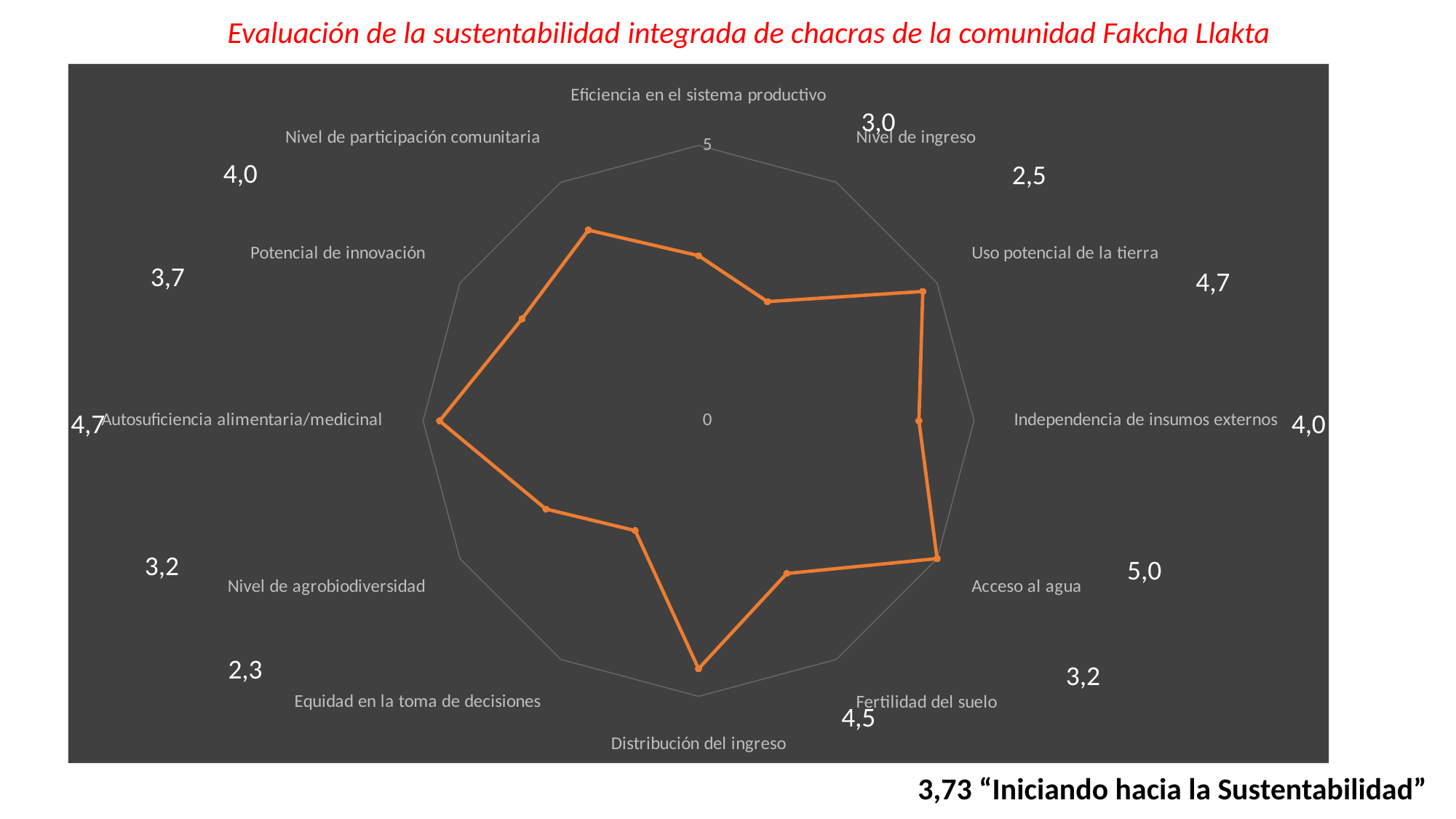
What is the value for Equidad en la toma de decisiones? 2,3 What is the maximum value shown on the radar chart's scale? 5 What is the value for Uso potencial de la tierra? 4,7 What is the difference between the values for Acceso al agua and Nivel de ingreso? 2,5 Which category has the highest value? Acceso al agua What is the value for Acceso al agua? 5,0 What is the value for Nivel de ingreso? 2,5 Which is larger, the value for Potencial de innovación or the value for Nivel de agrobiodiversidad? Potencial de innovación Which category has the lowest value? Equidad en la toma de decisiones What type of chart is shown on the slide? Radar chart How many categories (axes) does the radar chart have? 12 What is the value for Distribución del ingreso? 4,5